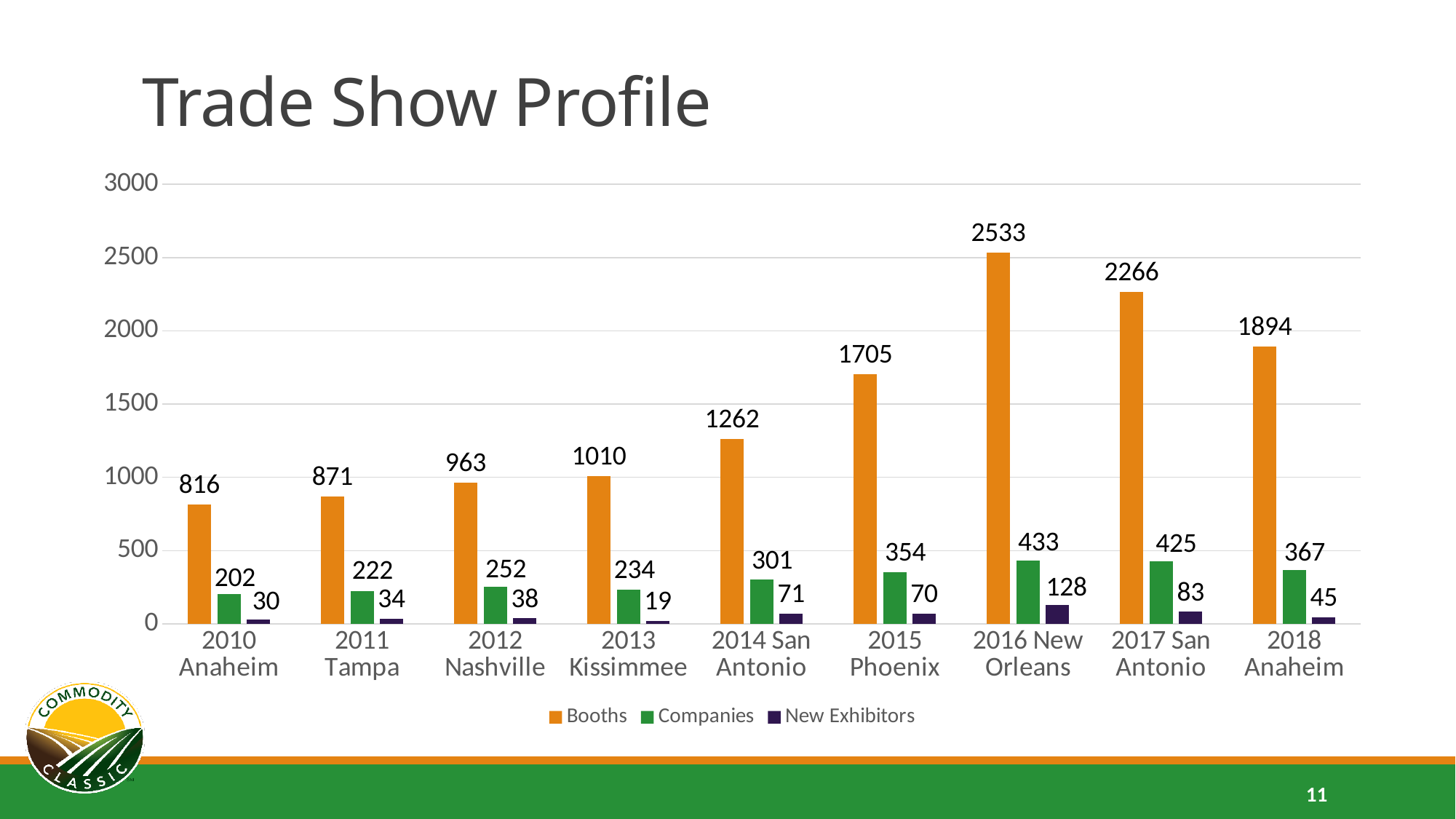
Which show had the lowest number of New Exhibitors? 2013 Kissimmee Which had more Companies, 2015 Phoenix or 2018 Anaheim? 2018 Anaheim How many Booths were there at the 2016 New Orleans show? 2533 How many New Exhibitors were there at the 2013 Kissimmee show? 19 What kind of chart is shown on the slide? Bar chart How many series does the legend list? 3 How many shows (categories) are shown on the x axis? 9 Which show had the highest number of Booths? 2016 New Orleans What is the difference in Booths between 2017 San Antonio and 2018 Anaheim? 372 Which series is shown in orange? Booths How many Companies exhibited at the 2014 San Antonio show? 301 Is the number of Booths for 2015 Phoenix greater or less than 1500? greater